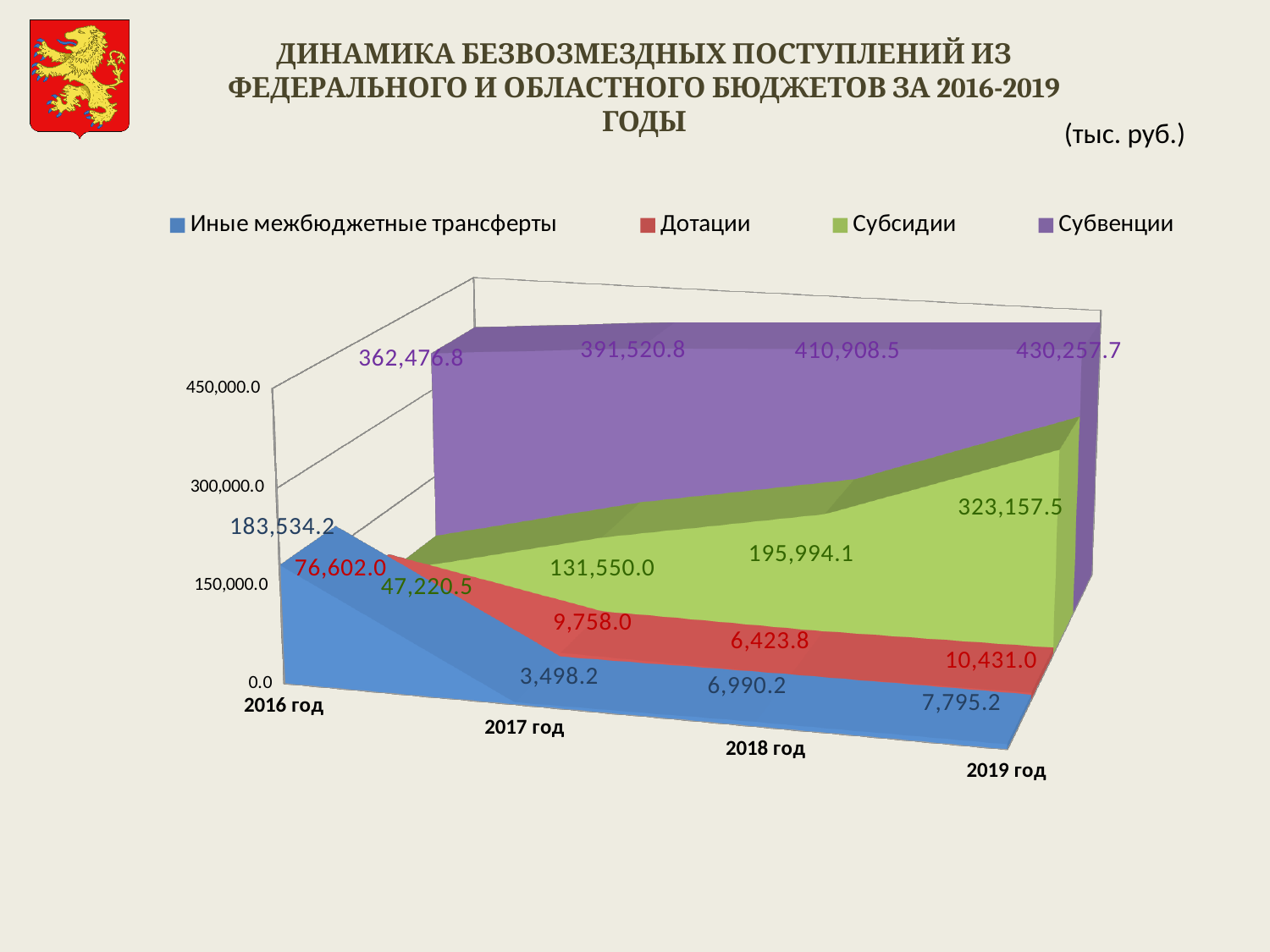
What is the value of Субвенции for 2019 год? 430,257.7 How many series does the legend list? 4 What kind of chart is shown on the slide? area chart How many years are shown on the x axis? 4 In which year is the value of Иные межбюджетные трансферты the lowest? 2017 год What is the value of Дотации for 2017 год? 9,758.0 By how much did Субвенции increase from 2016 год to 2019 год? 67,780.9 Do the values of Субвенции rise or fall from 2016 год to 2019 год? rise What is the value of Субсидии for 2018 год? 195,994.1 What is the value of Иные межбюджетные трансферты for 2016 год? 183,534.2 Which year has the larger value of Дотации, 2018 год or 2019 год? 2019 год In which year is the value of Субвенции the highest? 2019 год